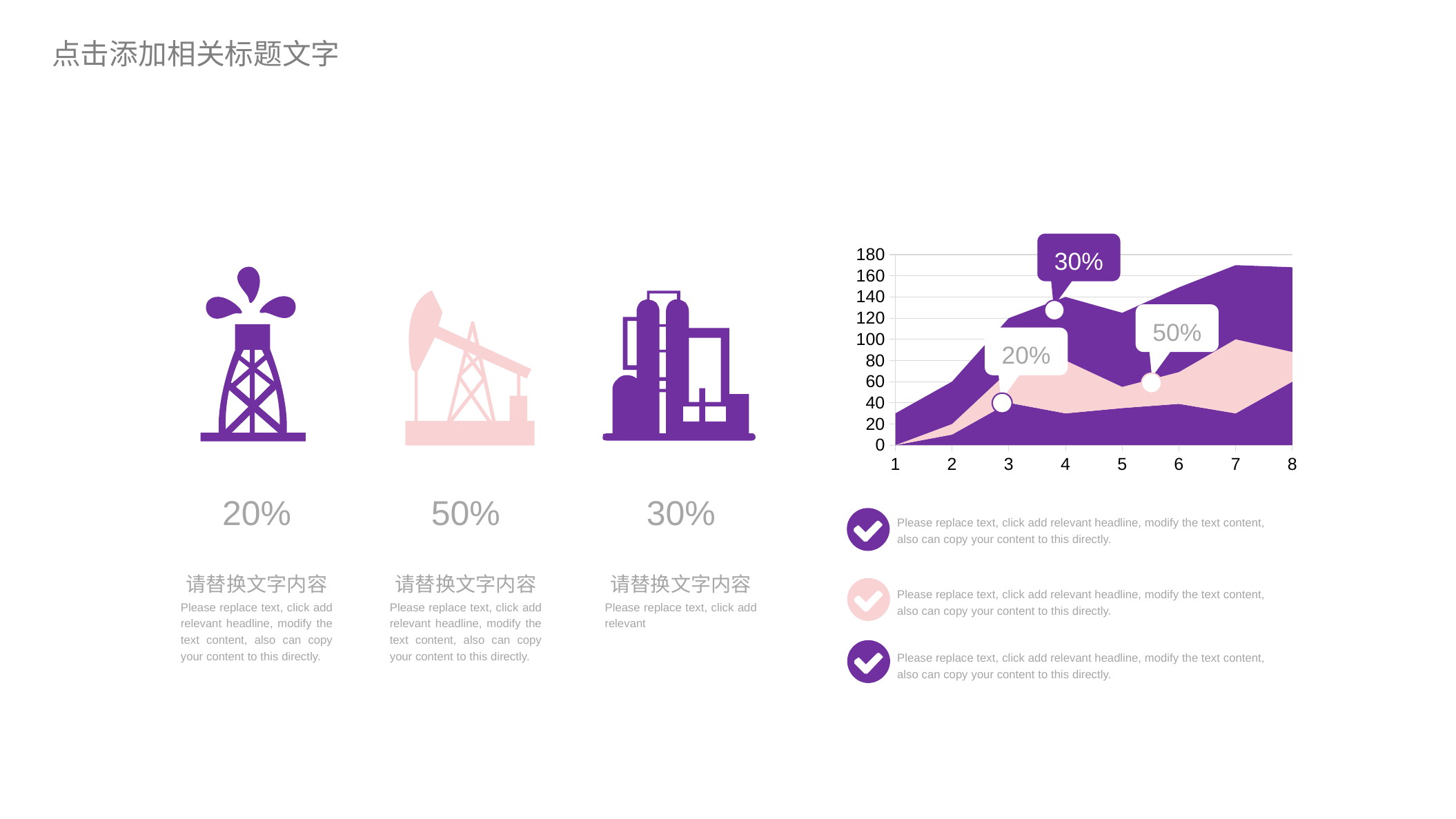
In the area chart, is the value of the purple series at x = 1 greater or less than 60? less At which x value is the pink series highest in the area chart? 7 Does the purple series in the area chart generally rise or fall from x = 1 to x = 8? rise At which x value is the purple series lowest in the area chart? 1 What kind of chart is shown on the right side of the slide? area chart In the area chart, is the value of the pink series at x = 7 greater or less than 60? greater In the area chart, is the value of the pink series at x = 1 greater or less than 20? less How many points are labelled along the x axis of the area chart? 8 In the area chart, is the purple series larger at x = 7 or at x = 1? x = 7 How many data series are plotted in the area chart? 3 What is the highest tick value shown on the y axis of the area chart? 180